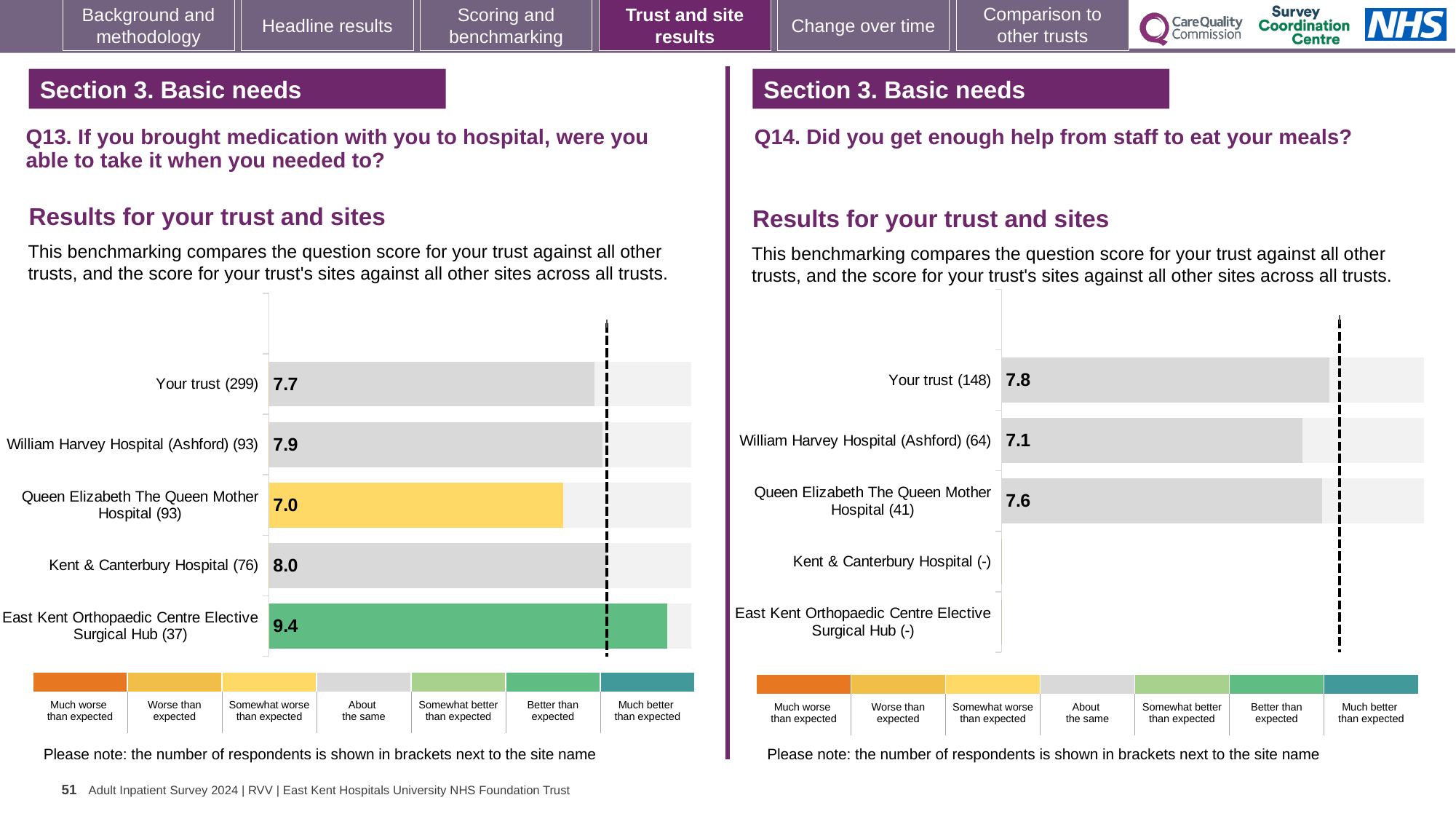
On the Q13 chart (left), how many bars are plotted? 5 On the Q13 chart (left), which site has the lowest score? Queen Elizabeth The Queen Mother Hospital On the Q13 chart (left), which has the higher score: William Harvey Hospital (Ashford) or Your trust? William Harvey Hospital (Ashford) On the Q13 chart (left), what is the difference between the scores for East Kent Orthopaedic Centre Elective Surgical Hub and Queen Elizabeth The Queen Mother Hospital? 2.4 On the Q14 chart (right), what is the score for William Harvey Hospital (Ashford)? 7.1 On the Q13 chart (left), what is the score for Your trust? 7.7 On the Q13 chart (left), which site has the highest score? East Kent Orthopaedic Centre Elective Surgical Hub On the Q14 chart (right), what is the score for Queen Elizabeth The Queen Mother Hospital? 7.6 On the Q14 chart (right), what is the difference between the scores for Your trust and William Harvey Hospital (Ashford)? 0.7 On the Q13 chart (left), what is the score for Kent & Canterbury Hospital? 8.0 On the Q14 chart (right), which site with a plotted score has the lowest score? William Harvey Hospital (Ashford) What kind of chart is used on the Q13 chart (left)? Bar chart